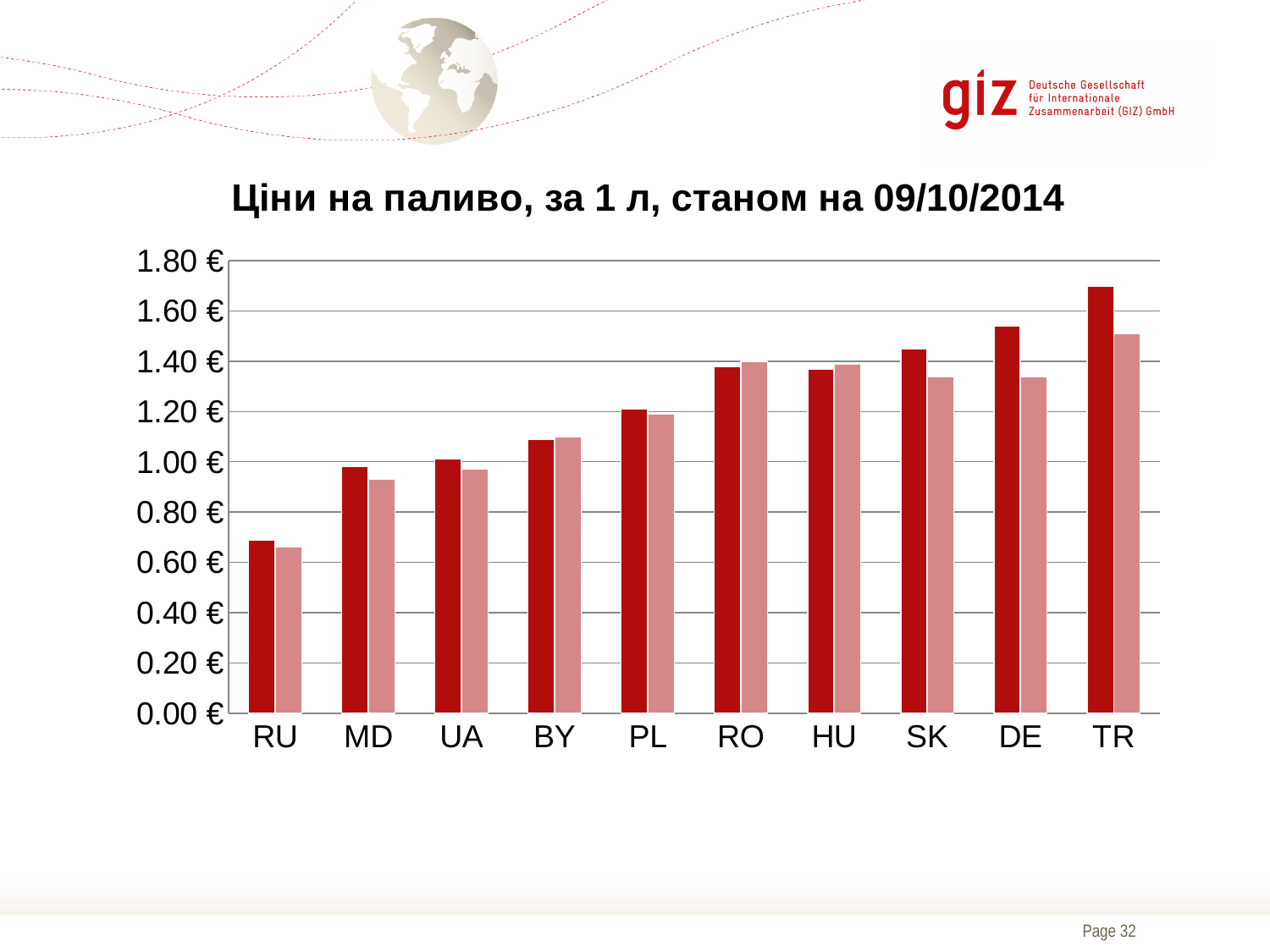
Is the dark red bar for DE greater or less than 1.40 €? greater Do the dark red bars generally rise or fall from RU on the left to TR on the right? rise Which country has the shortest dark red bar? RU Is the light red bar for RU greater or less than 0.80 €? less What kind of chart is shown on the slide? bar chart How many countries are shown on the x axis of the chart? 10 Is the dark red bar for TR greater or less than 1.60 €? greater Which has the taller dark red bar, SK or HU? SK What is the title of the chart? Ціни на паливо, за 1 л, станом на 09/10/2014 For DE, which bar is taller, the dark red one or the light red one? dark red Which country has the tallest dark red bar? TR